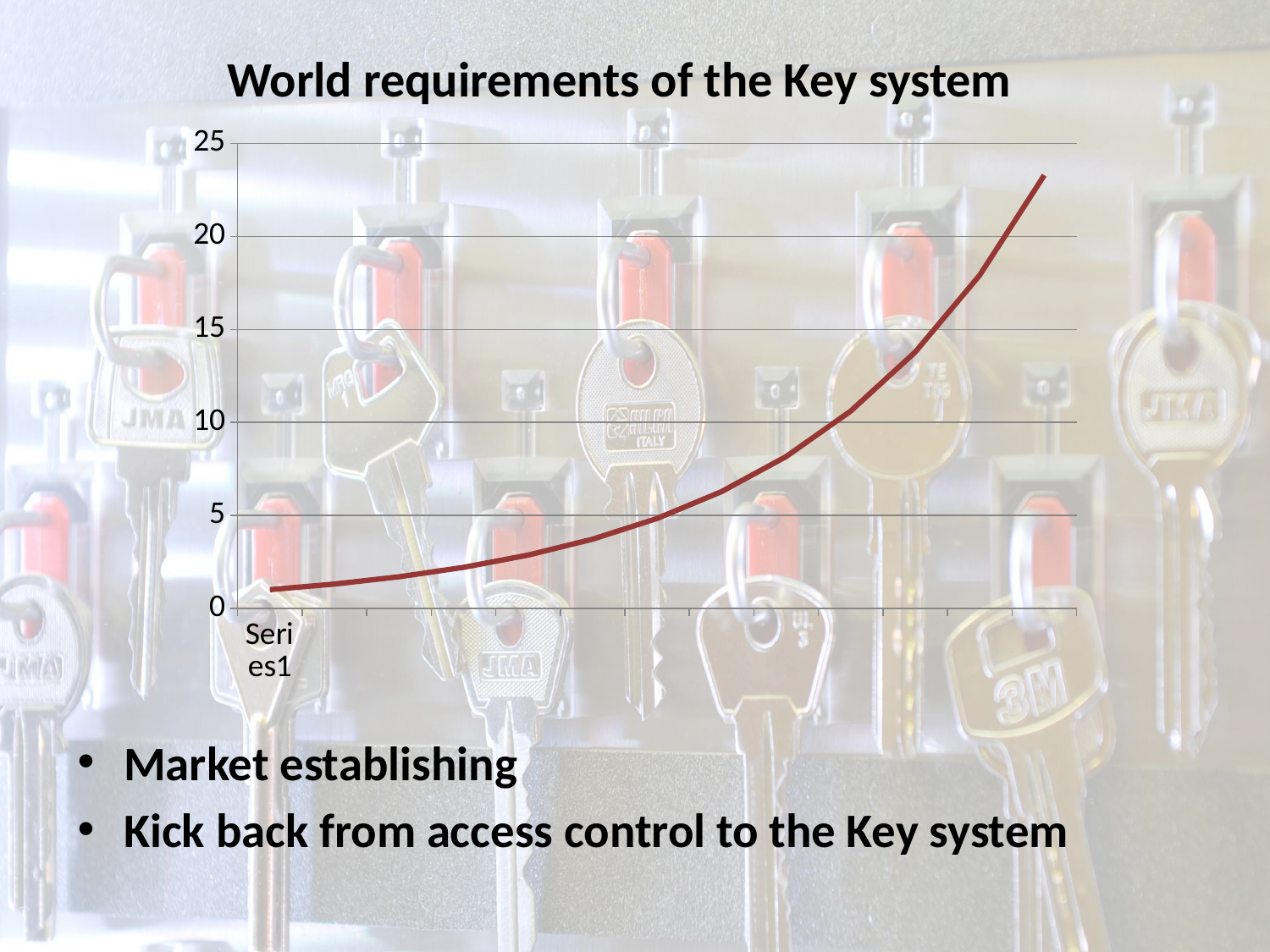
Which end of the line is higher, the left end or the right end? the right end Is the value at the right-hand end of the line greater or less than 20? greater Is the value at the left-hand start of the line greater or less than 5? less Is the value at the right-hand end of the line greater or less than 25? less What is the title of the chart? World requirements of the Key system What kind of chart is shown on the slide? line chart What is the highest value shown on the vertical axis? 25 Do the values of the line rise or fall from left to right along the x axis? rise